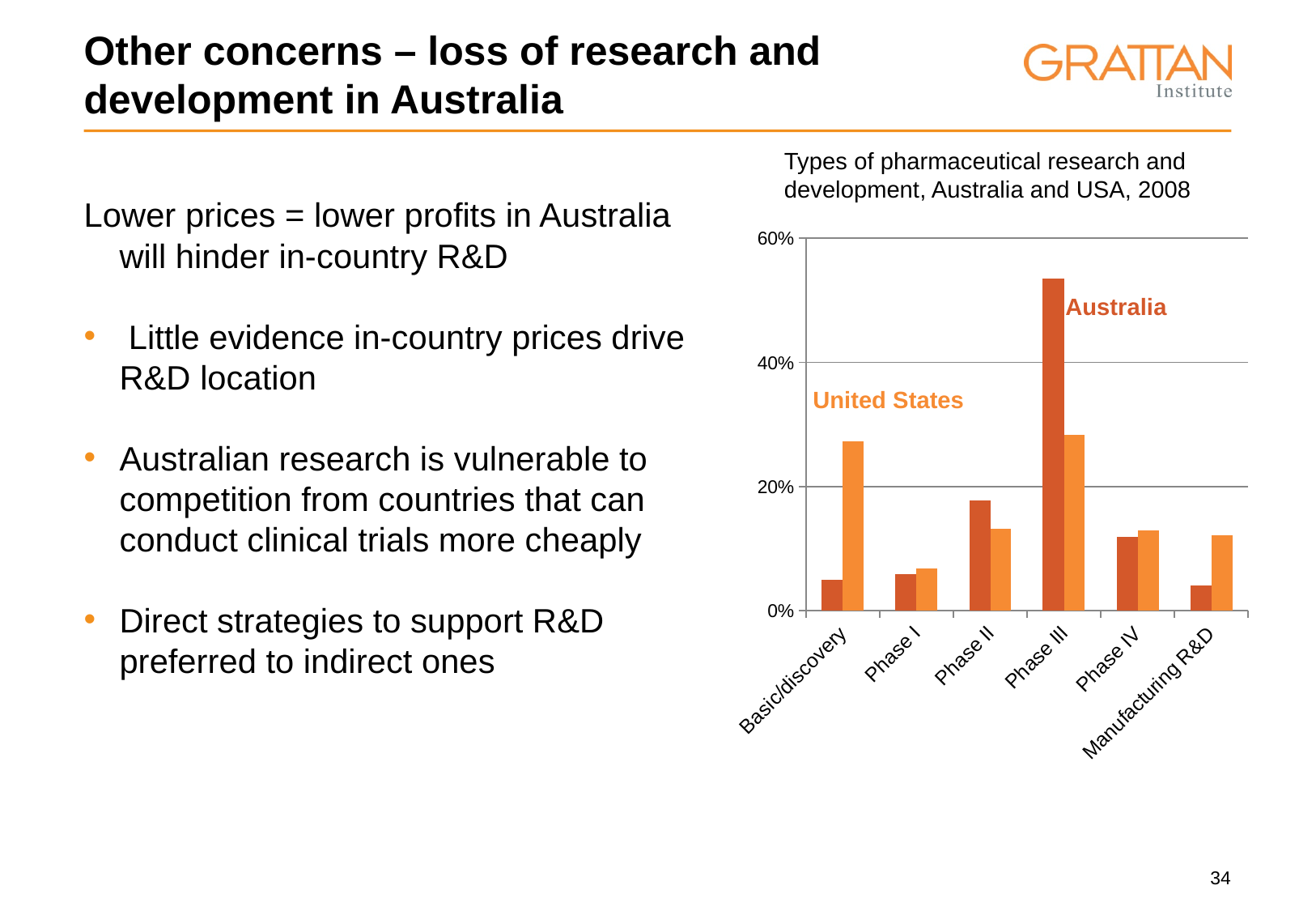
How many series does the chart show? 2 Which category has the highest value for the United States? Phase III Which category has the highest value for Australia? Phase III Is the value for the United States in Basic/discovery greater or less than 20%? greater Is the value for Australia in Phase III greater or less than 40%? greater In Phase III, which has the larger value, Australia or the United States? Australia What kind of chart is shown on the slide? Bar chart Is the value for Australia in Basic/discovery greater or less than 20%? less What is the title of the chart? Types of pharmaceutical research and development, Australia and USA, 2008 How many categories of research and development are shown on the x axis of the chart? 6 In Basic/discovery, which has the larger value, Australia or the United States? United States